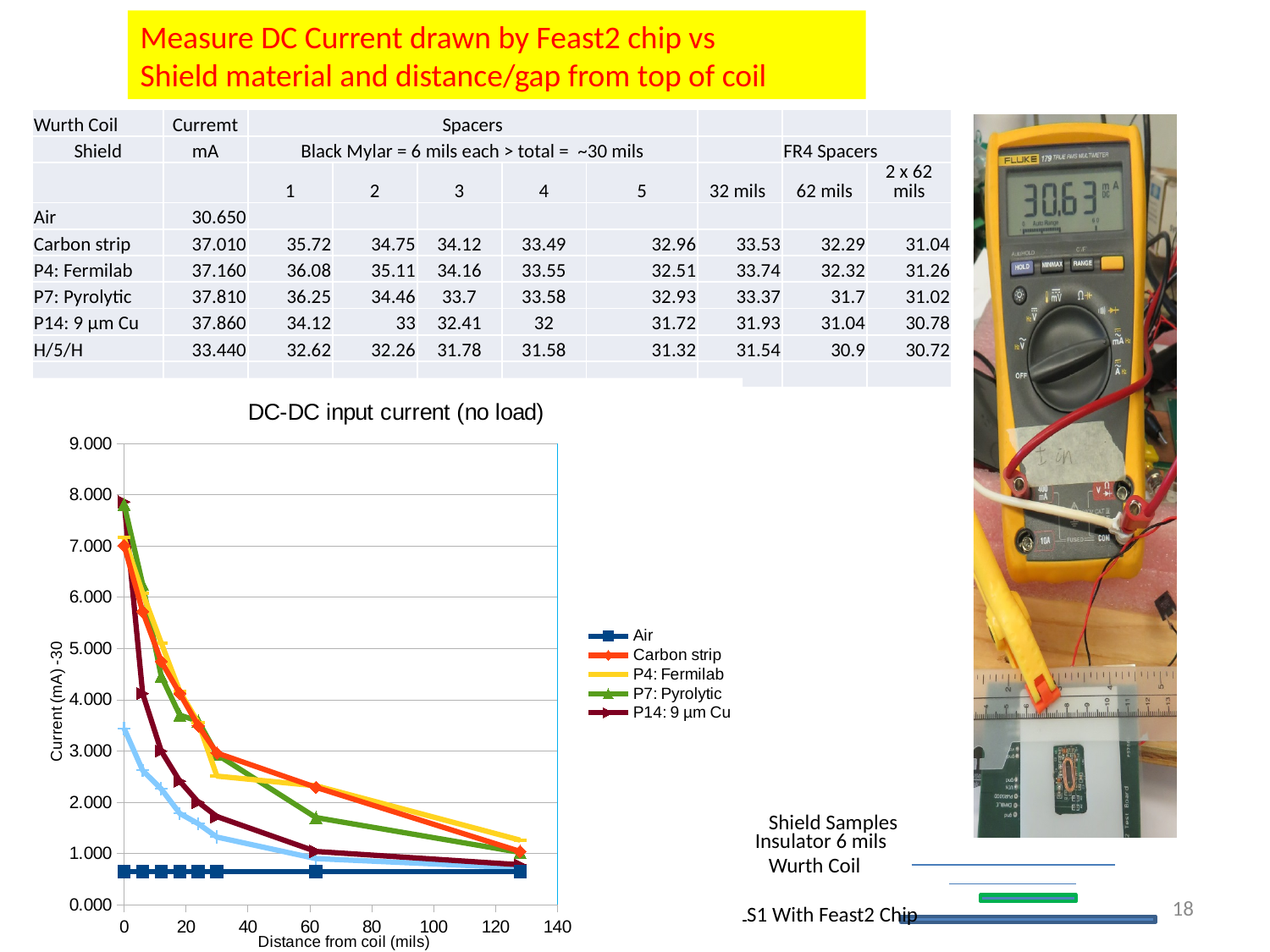
How many series does the legend of the "DC-DC input current (no load)" chart list? 5 In the "DC-DC input current (no load)" chart, which series stays lowest across all distances? Air In the "DC-DC input current (no load)" chart, do the Carbon strip values rise or fall as distance from the coil increases? fall In the "DC-DC input current (no load)" chart, is the Carbon strip value at about 62 mils greater or less than 2.000? greater What is the x-axis title of the "DC-DC input current (no load)" chart? Distance from coil (mils) In the "DC-DC input current (no load)" chart, is the Carbon strip value at 0 mils greater or less than 6.000? greater What kind of chart is "DC-DC input current (no load)"? line chart In the "DC-DC input current (no load)" chart, is the P7: Pyrolytic value at about 62 mils greater or less than 2.000? less What is the y-axis title of the "DC-DC input current (no load)" chart? Current (mA) -30 In the "DC-DC input current (no load)" chart, at about 62 mils, which is higher: Carbon strip or P14: 9 µm Cu? Carbon strip In the "DC-DC input current (no load)" chart, at about 128 mils, which is higher: P4: Fermilab or P14: 9 µm Cu? P4: Fermilab